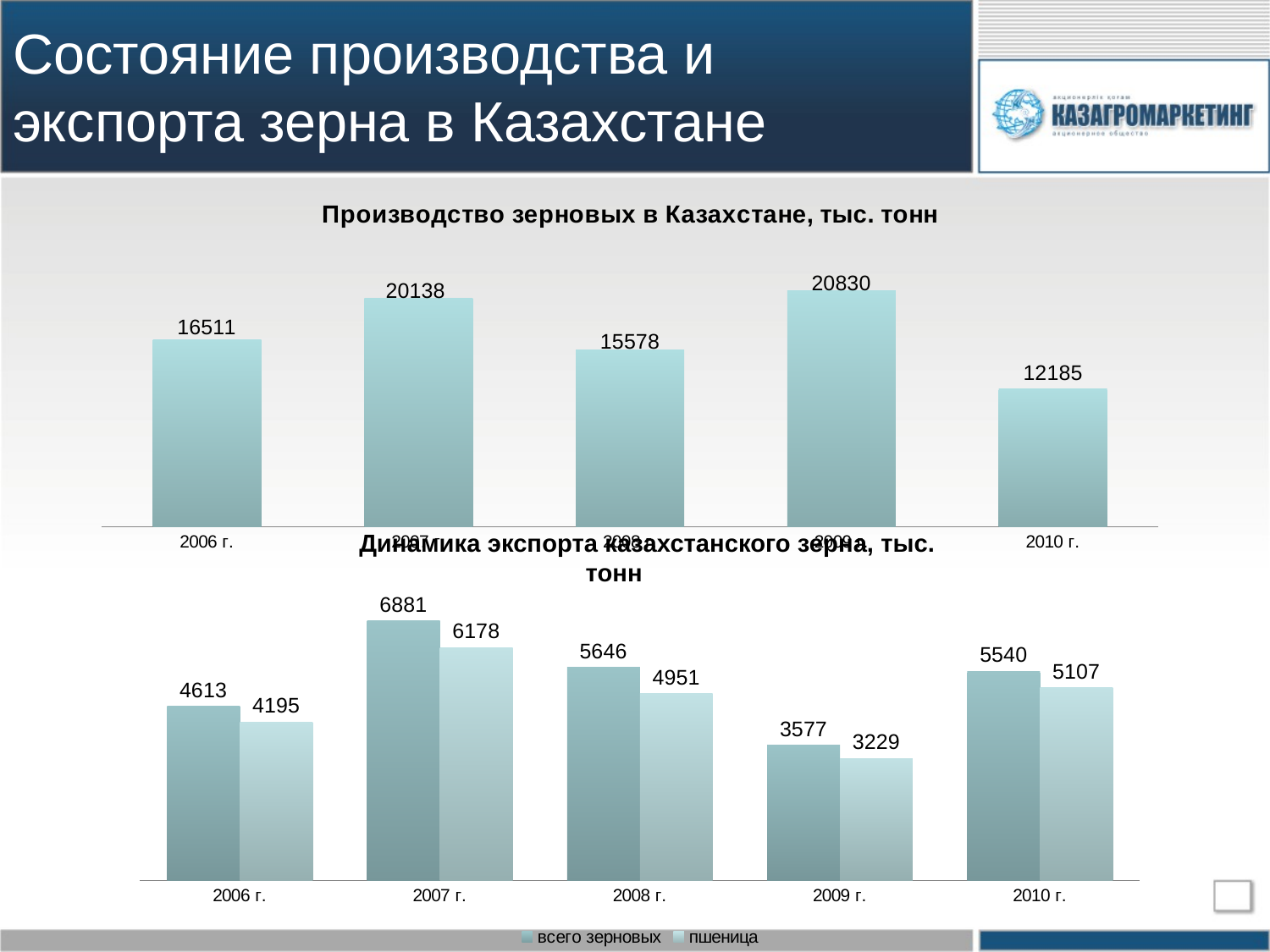
In the chart 'Производство зерновых в Казахстане, тыс. тонн', which year has the lowest value? 2010 г. How many series does the legend of the chart 'Динамика экспорта казахстанского зерна, тыс. тонн' list? 2 In the chart 'Производство зерновых в Казахстане, тыс. тонн', what is the value for 2010 г.? 12185 In the chart 'Динамика экспорта казахстанского зерна, тыс. тонн', what is the difference between 'всего зерновых' and 'пшеница' in 2007 г.? 703 In the chart 'Динамика экспорта казахстанского зерна, тыс. тонн', which year has the highest value for 'всего зерновых'? 2007 г. In the chart 'Производство зерновых в Казахстане, тыс. тонн', what is the difference between the values for 2006 г. and 2010 г.? 4326 What type of chart is 'Динамика экспорта казахстанского зерна, тыс. тонн'? Bar chart In the chart 'Динамика экспорта казахстанского зерна, тыс. тонн', what is the value of 'пшеница' for 2008 г.? 4951 In the chart 'Динамика экспорта казахстанского зерна, тыс. тонн', what is the value of 'всего зерновых' for 2009 г.? 3577 In the chart 'Производство зерновых в Казахстане, тыс. тонн', which year has the highest value? 2009 г. How many bars are shown in the chart 'Производство зерновых в Казахстане, тыс. тонн'? 5 In the chart 'Производство зерновых в Казахстане, тыс. тонн', what is the value for 2006 г.? 16511